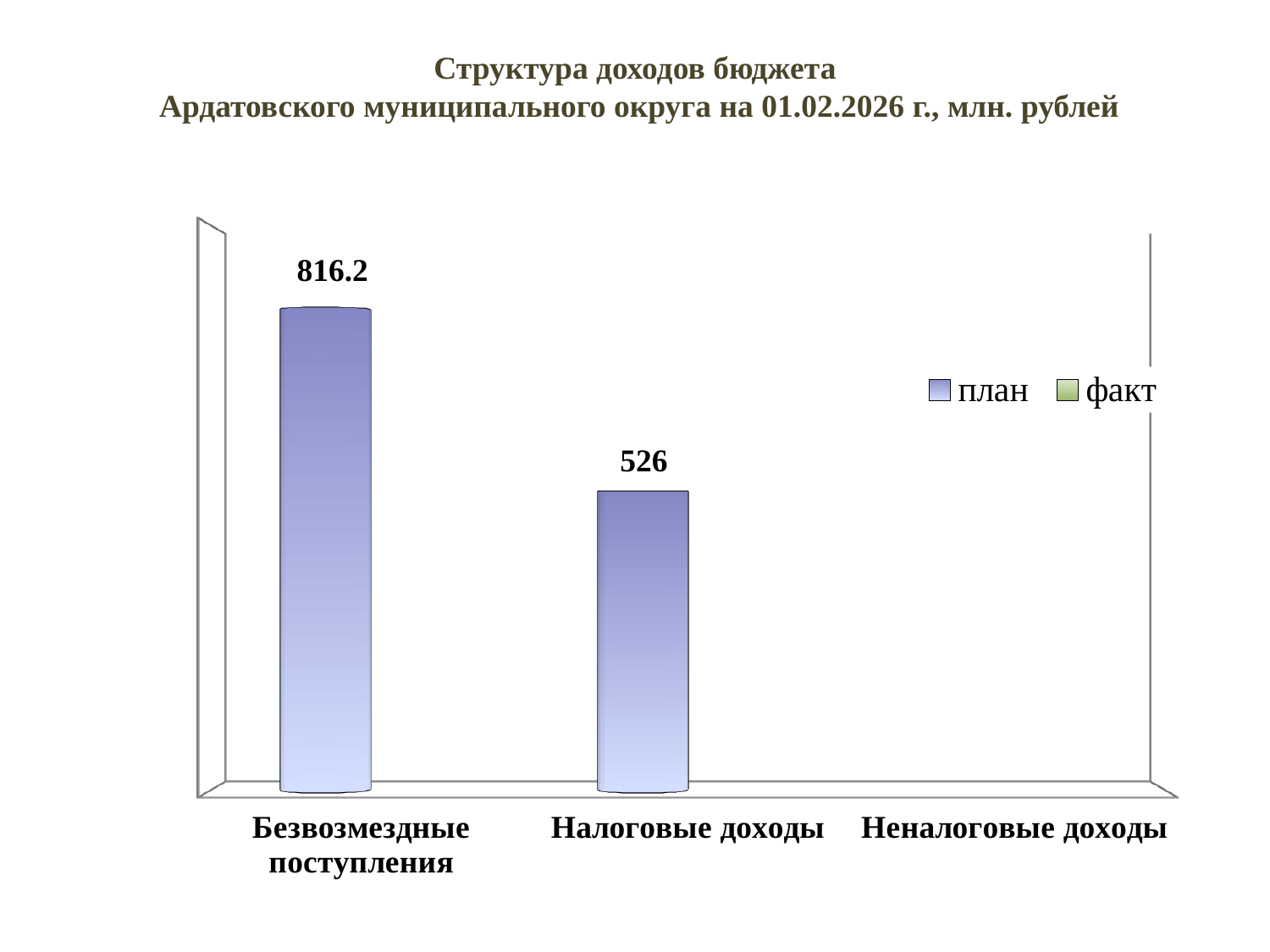
What kind of chart is shown on the slide? bar chart What is the план value for Налоговые доходы? 526 Which is larger, the план value for Безвозмездные поступления or for Налоговые доходы? Безвозмездные поступления Which category has no visible bar plotted? Неналоговые доходы Which category has the highest plotted value? Безвозмездные поступления What unit of measurement is stated in the chart title? млн. рублей What is the difference between the план values for Безвозмездные поступления and Налоговые доходы? 290.2 What are the two series named in the legend? план and факт How many categories are shown on the x axis? 3 What is the план value for Безвозмездные поступления? 816.2 How many series does the legend list? 2